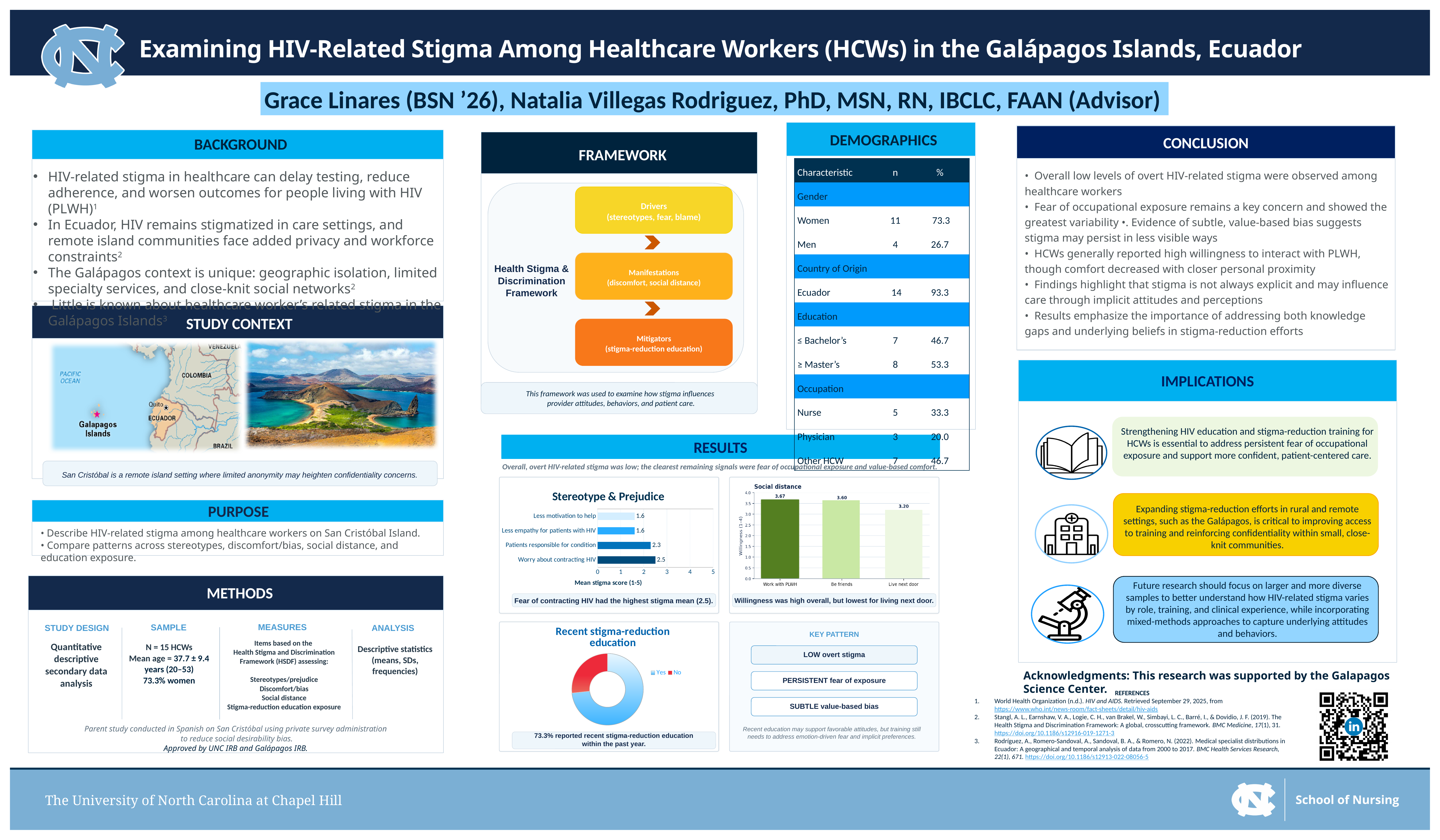
What type of chart is the Stereotype & Prejudice chart? Bar chart In the Recent stigma-reduction education chart, what share of respondents reported recent stigma-reduction education (Yes)? 73.3% In the Social distance chart, which category has the lowest willingness value? Live next door In the Social distance chart, do the values rise or fall from left to right across the categories? Fall In the Social distance chart, what is the difference between the values for 'Work with PLWH' and 'Live next door'? 0.47 In the Stereotype & Prejudice chart, which item has the highest mean stigma score? Worry about contracting HIV In the Stereotype & Prejudice chart, what is the mean stigma score for 'Worry about contracting HIV'? 2.5 In the Stereotype & Prejudice chart, what is the mean stigma score for 'Patients responsible for condition'? 2.3 How many items are plotted in the Stereotype & Prejudice chart? 4 In the Social distance chart, what is the willingness value for 'Live next door'? 3.20 In the Social distance chart, what is the willingness value for 'Work with PLWH'? 3.67 In the Stereotype & Prejudice chart, what is the difference between the scores for 'Worry about contracting HIV' and 'Less empathy for patients with HIV'? 0.9